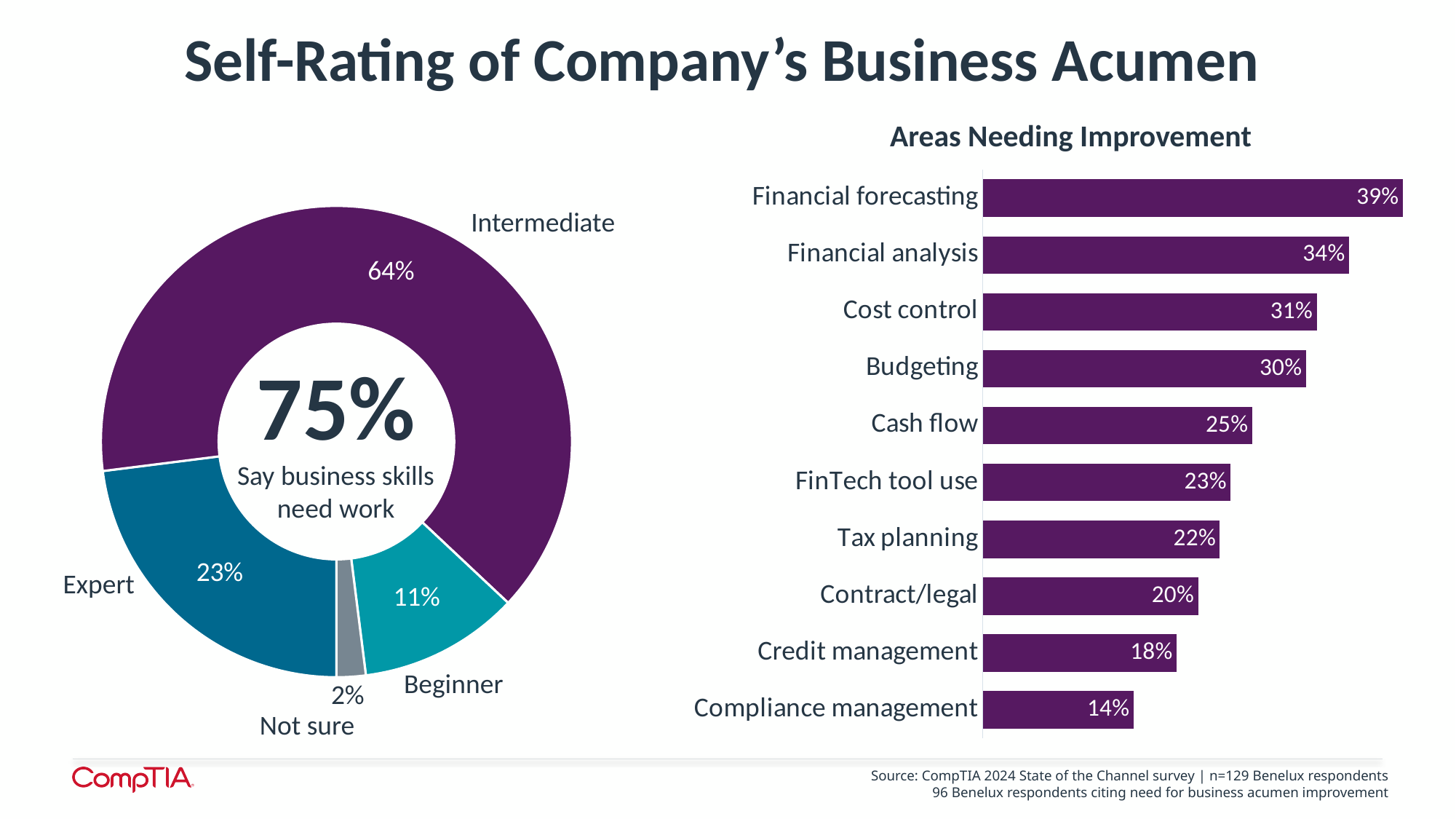
In the donut chart on the left, what is the difference between the Expert and Beginner shares? 12 percentage points In the Areas Needing Improvement chart, which area has the lowest value? Compliance management In the Areas Needing Improvement chart, what is the value for Cost control? 31% In the donut chart on the left, how many categories are shown? 4 What type of chart is the Areas Needing Improvement chart? Bar chart In the Areas Needing Improvement chart, which is larger: Cash flow or Tax planning? Cash flow In the donut chart on the left, which category has the largest share? Intermediate In the donut chart on the left, what percentage of respondents answered Not sure? 2% In the Areas Needing Improvement chart, what is the difference between Financial forecasting and Financial analysis? 5 percentage points In the Areas Needing Improvement chart, how many areas are listed? 10 In the Areas Needing Improvement chart, which area has the highest value? Financial forecasting In the donut chart on the left, what share of respondents rated their company's business acumen as Intermediate? 64%